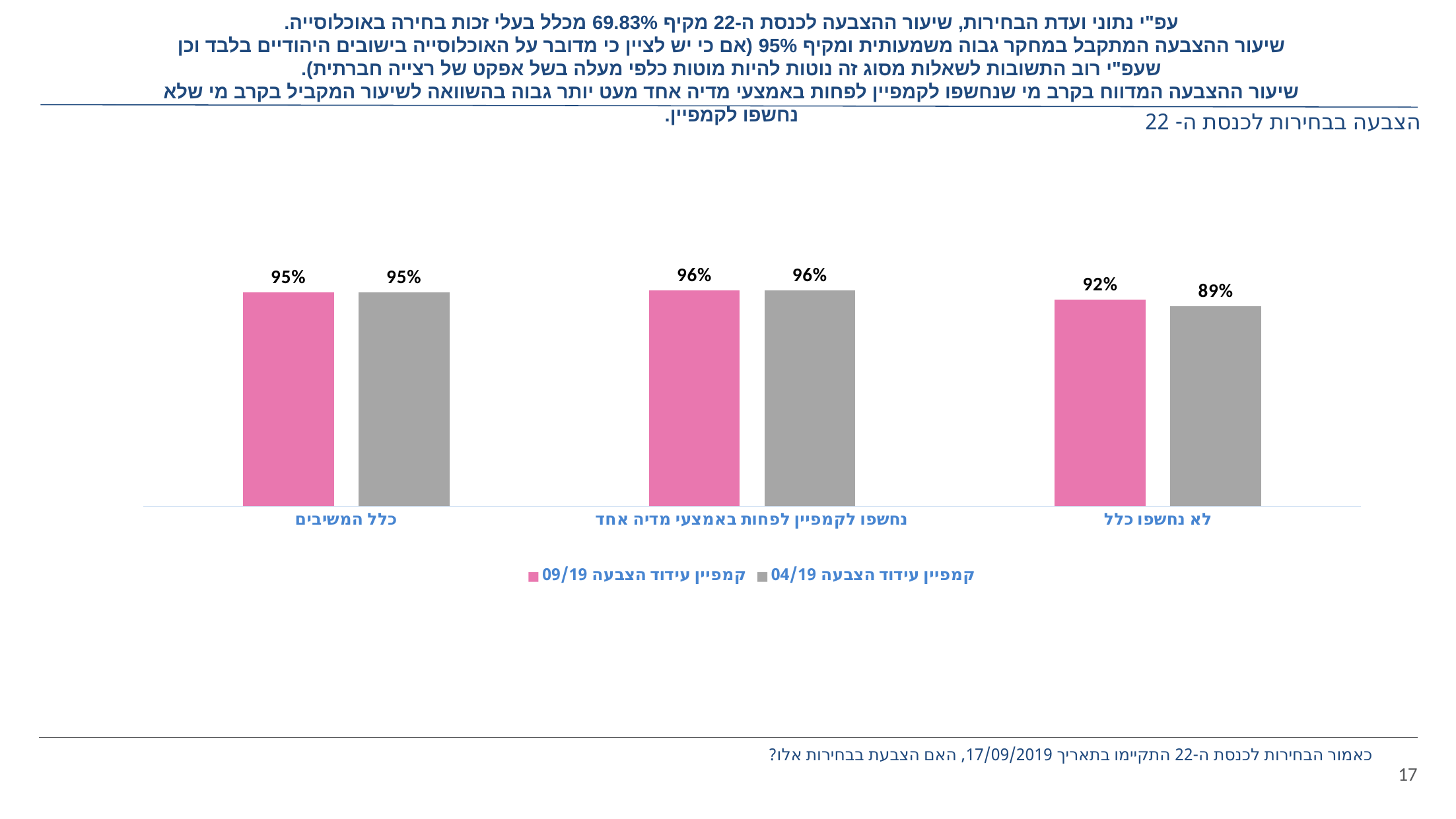
What colour are the bars for the 'קמפיין עידוד הצבעה 09/19' series? Pink For 'לא נחשפו כלל', which series has the larger value, 09/19 or 04/19? קמפיין עידוד הצבעה 09/19 What is the value for 'לא נחשפו כלל' in the 'קמפיין עידוד הצבעה 04/19' series? 89% What kind of chart is shown on the slide? Bar chart What is the value for 'כלל המשיבים' in the 'קמפיין עידוד הצבעה 09/19' series? 95% Which category has the highest value in the 'קמפיין עידוד הצבעה 09/19' series? נחשפו לקמפיין לפחות באמצעי מדיה אחד How many series does the chart legend list? 2 What is the difference between the 09/19 and 04/19 values for 'לא נחשפו כלל'? 3% What is the value for 'לא נחשפו כלל' in the 'קמפיין עידוד הצבעה 09/19' series? 92% What is the value for 'נחשפו לקמפיין לפחות באמצעי מדיה אחד' in the 'קמפיין עידוד הצבעה 04/19' series? 96% How many categories are shown on the x axis of the chart? 3 Which category has the lowest value in the 'קמפיין עידוד הצבעה 04/19' series? לא נחשפו כלל